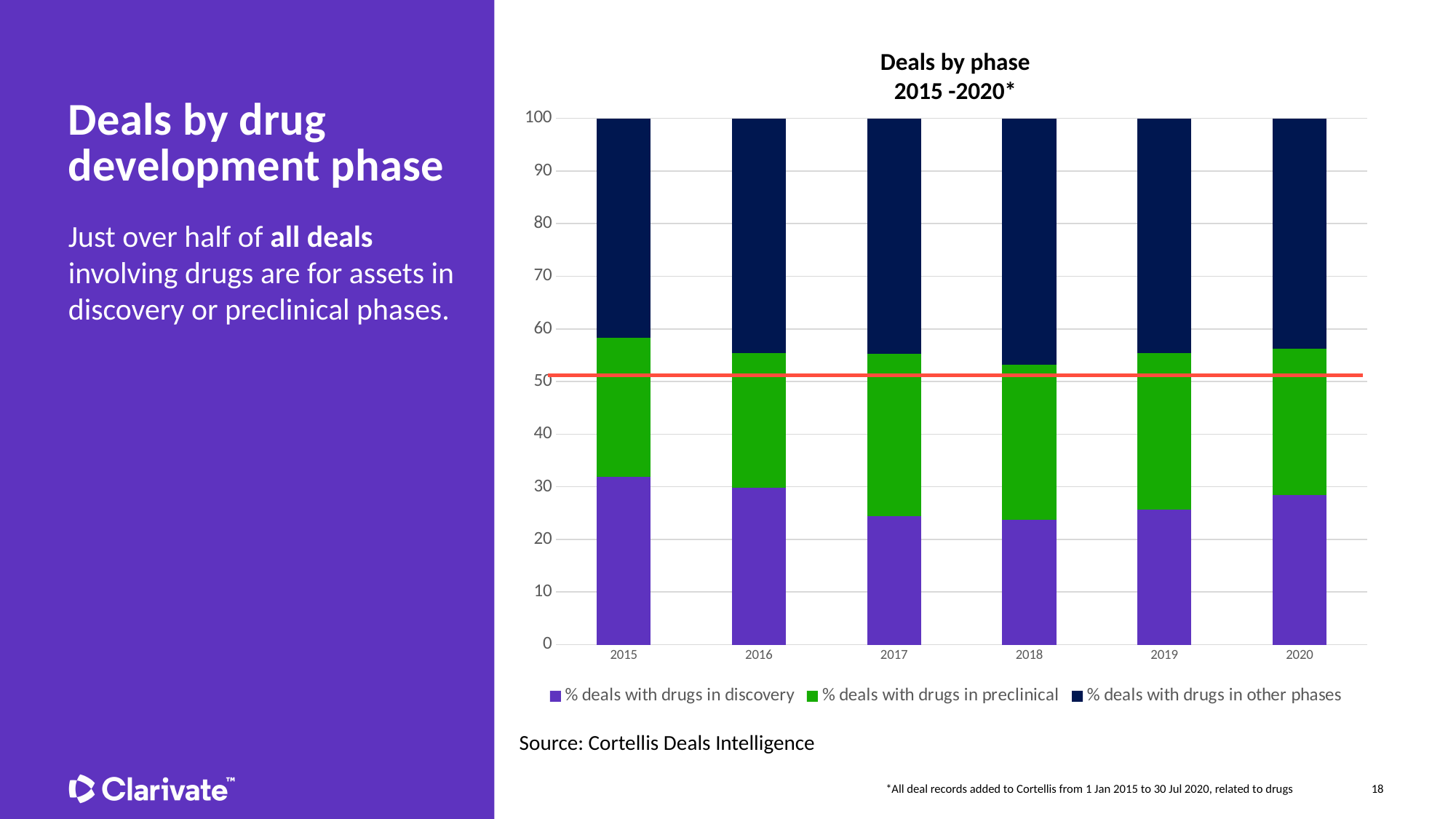
What kind of chart is shown on the slide? stacked bar chart Is the value for '% deals with drugs in discovery' in 2015 greater or less than 30? greater In which year is the '% deals with drugs in discovery' segment the largest? 2015 Which colour represents '% deals with drugs in discovery' in the chart? purple Which year has the larger '% deals with drugs in discovery' segment, 2015 or 2018? 2015 Is the value for '% deals with drugs in discovery' in 2020 greater or less than 20? greater How many series does the chart legend list? 3 Which year has the larger '% deals with drugs in discovery' segment, 2017 or 2020? 2020 What is the title of the chart? Deals by phase 2015 -2020* Is the value for '% deals with drugs in discovery' in 2018 greater or less than 30? less What is the total height of the stacked bar for 2015? 100 How many years are shown on the x axis of the chart? 6